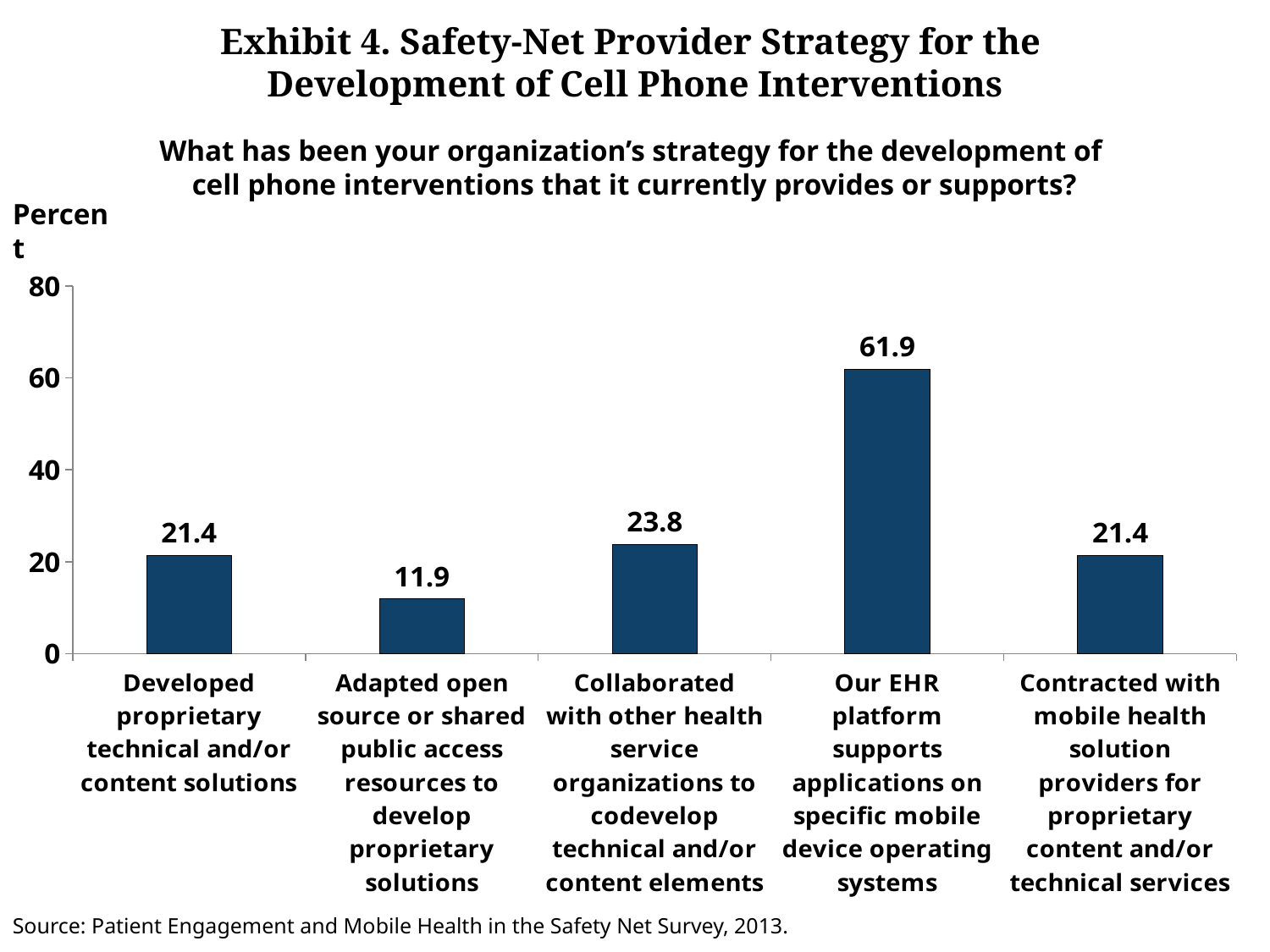
Which strategy has the highest value? Our EHR platform supports applications on specific mobile device operating systems What is the value for "Collaborated with other health service organizations to codevelop technical and/or content elements"? 23.8 What is the difference between the value for "Our EHR platform supports applications on specific mobile device operating systems" and the value for "Collaborated with other health service organizations to codevelop technical and/or content elements"? 38.1 Which is larger: the value for "Collaborated with other health service organizations to codevelop technical and/or content elements" or the value for "Contracted with mobile health solution providers for proprietary content and/or technical services"? Collaborated with other health service organizations to codevelop technical and/or content elements What kind of chart is shown on the slide? bar chart What is the label on the vertical axis of the chart? Percent What is the value for "Adapted open source or shared public access resources to develop proprietary solutions"? 11.9 What is the value for "Our EHR platform supports applications on specific mobile device operating systems"? 61.9 What is the value for "Developed proprietary technical and/or content solutions"? 21.4 How many strategy categories are shown in the chart? 5 Which strategy has the lowest value? Adapted open source or shared public access resources to develop proprietary solutions Is the value for "Our EHR platform supports applications on specific mobile device operating systems" greater or less than 60? greater